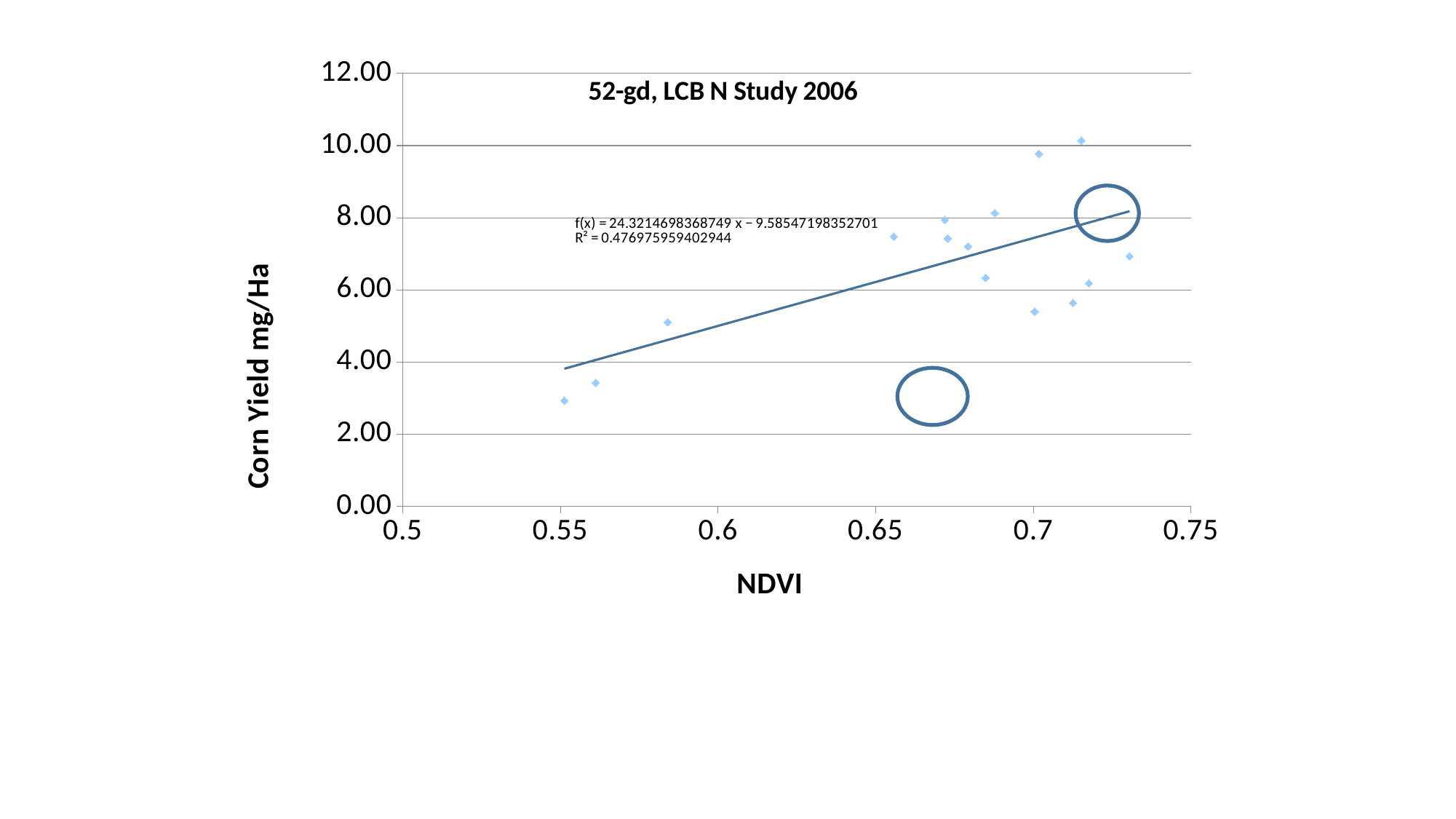
Is the corn yield of the point at NDVI about 0.731 greater or less than 8.00? less What kind of chart is shown on the slide? Scatter chart Does corn yield generally rise or fall as NDVI increases along the x axis? Rise What is the R² value shown on the chart? 0.476975959402944 Is the corn yield of the point at NDVI about 0.584 greater or less than 4.00? greater What is the title of the chart? 52-gd, LCB N Study 2006 What is the label of the x axis? NDVI Is the highest plotted corn yield value greater or less than 10.00? greater Which is larger: the corn yield of the point near NDVI 0.716 or the point near NDVI 0.551? The point near NDVI 0.716 What is the maximum value shown on the y axis? 12.00 What is the trendline equation shown on the chart? f(x) = 24.3214698368749 x − 9.58547198352701